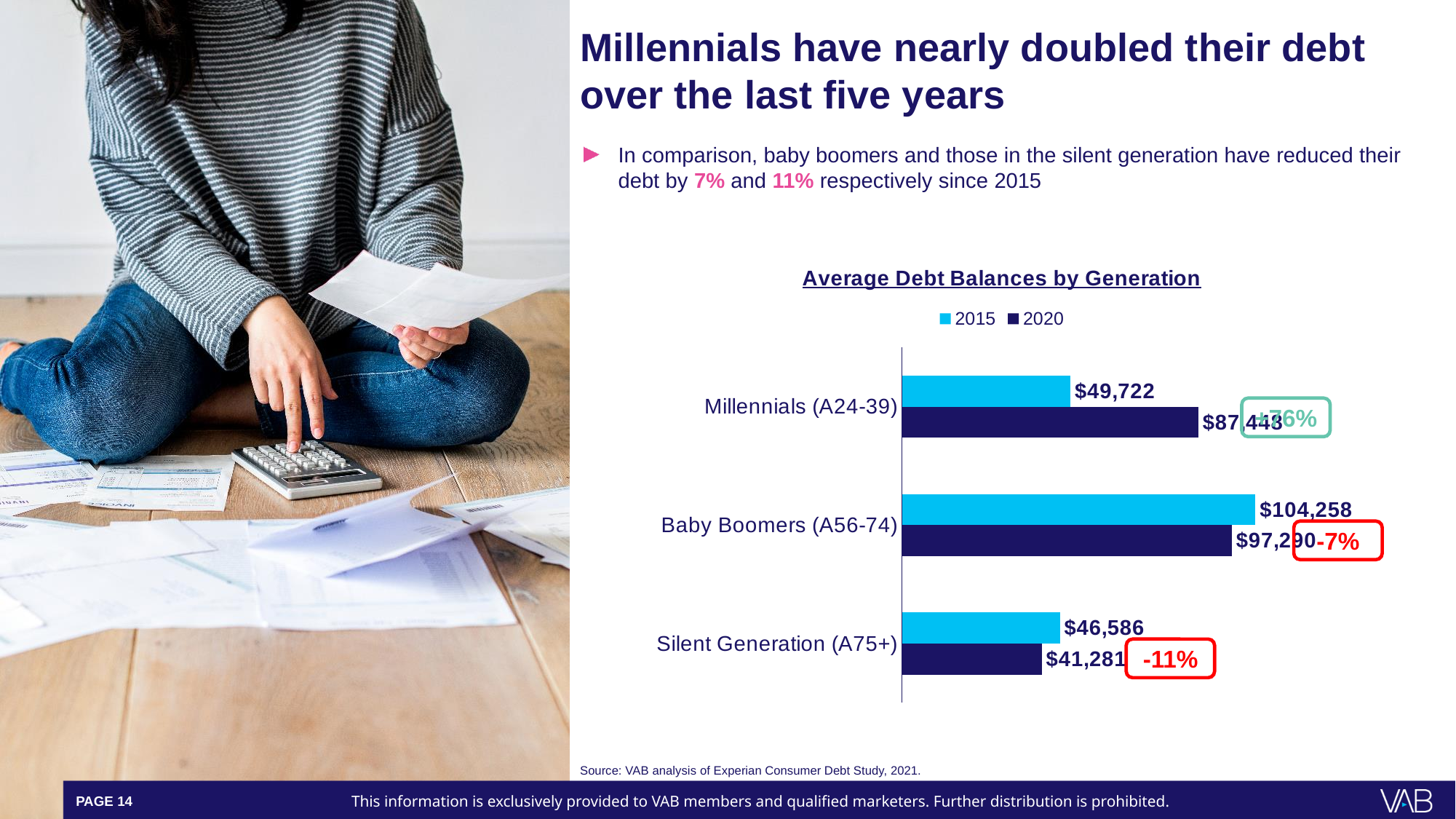
What is the average debt balance for the Silent Generation (A75+) in 2015? $46,586 What is the average debt balance for Baby Boomers (A56-74) in 2015? $104,258 What type of chart is used to show Average Debt Balances by Generation? Bar chart Which generation had the lowest average debt balance in 2015? Silent Generation (A75+) What is the average debt balance for Millennials (A24-39) in 2015? $49,722 For Millennials (A24-39), which year shows the larger average debt balance, 2015 or 2020? 2020 By how much did the Silent Generation's average debt balance fall from 2015 to 2020? $5,305 How many generations are shown in the chart? 3 What is the average debt balance for the Silent Generation (A75+) in 2020? $41,281 How many series does the legend list? 2 For Baby Boomers (A56-74), which year shows the larger average debt balance, 2015 or 2020? 2015 Which generation had the highest average debt balance in 2015? Baby Boomers (A56-74)